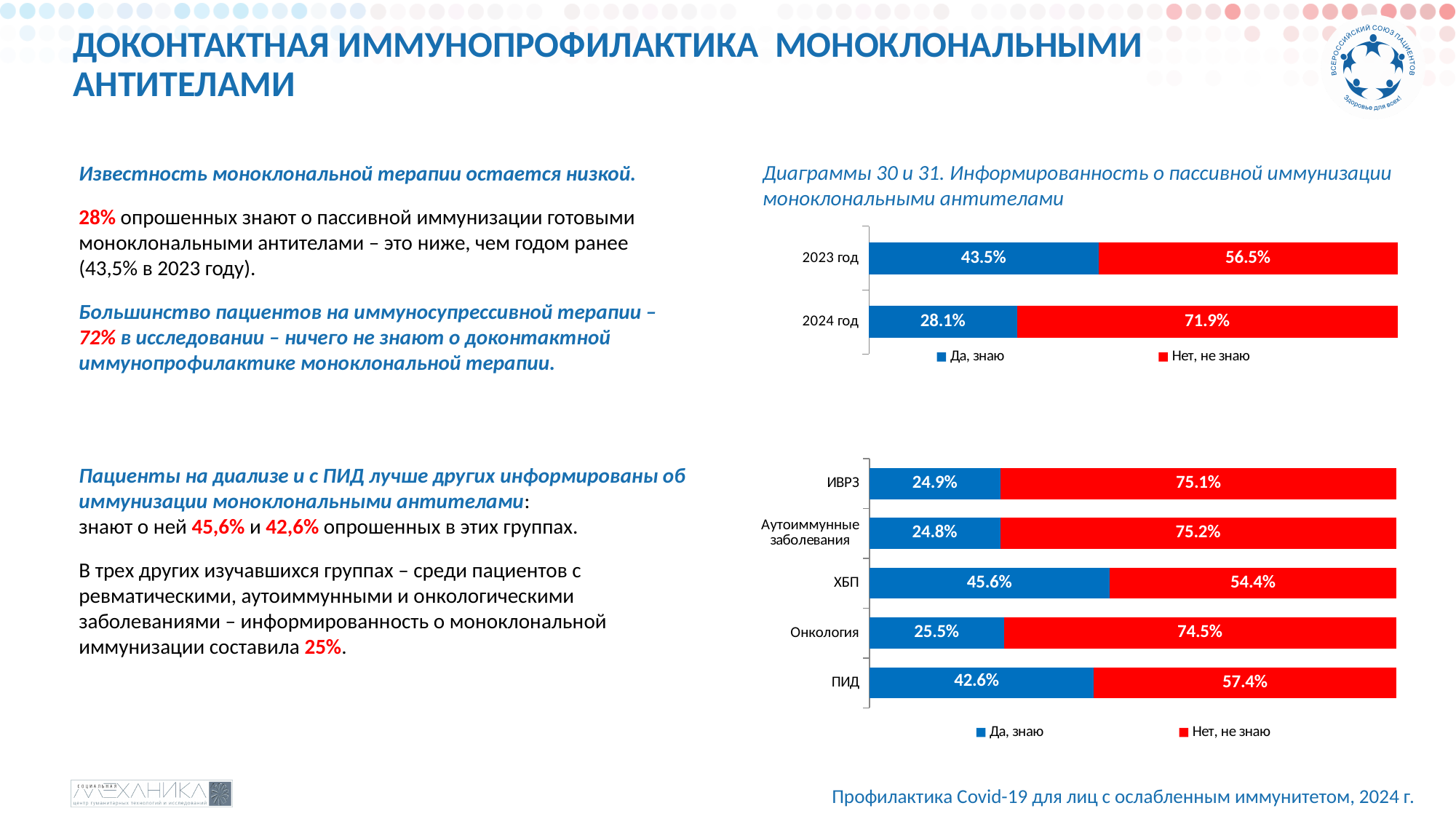
In the bottom chart (by patient group), what is the difference between the "Нет, не знаю" values for ИВРЗ and ХБП? 20.7 In the top chart (by year), by how many percentage points did the "Да, знаю" share fall from 2023 год to 2024 год? 15.4 In the bottom chart (by patient group), how many patient groups are shown? 5 In the bottom chart (by patient group), which is larger: the "Да, знаю" share for ХБП or for ПИД? ХБП In the bottom chart (by patient group), which group has the highest "Да, знаю" share? ХБП What type of chart is the bottom chart (by patient group)? Stacked bar chart In the bottom chart (by patient group), what is the "Да, знаю" value for ПИД? 42.6% In the bottom chart (by patient group), which group has the lowest "Да, знаю" share? Аутоиммунные заболевания In the bottom chart (by patient group), what is the "Нет, не знаю" value for Онкология? 74.5% In the top chart (by year), how many series does the legend list? 2 In the top chart (by year), what percentage answered "Да, знаю" in 2024 год? 28.1% In the top chart (by year), what percentage answered "Нет, не знаю" in 2023 год? 56.5%